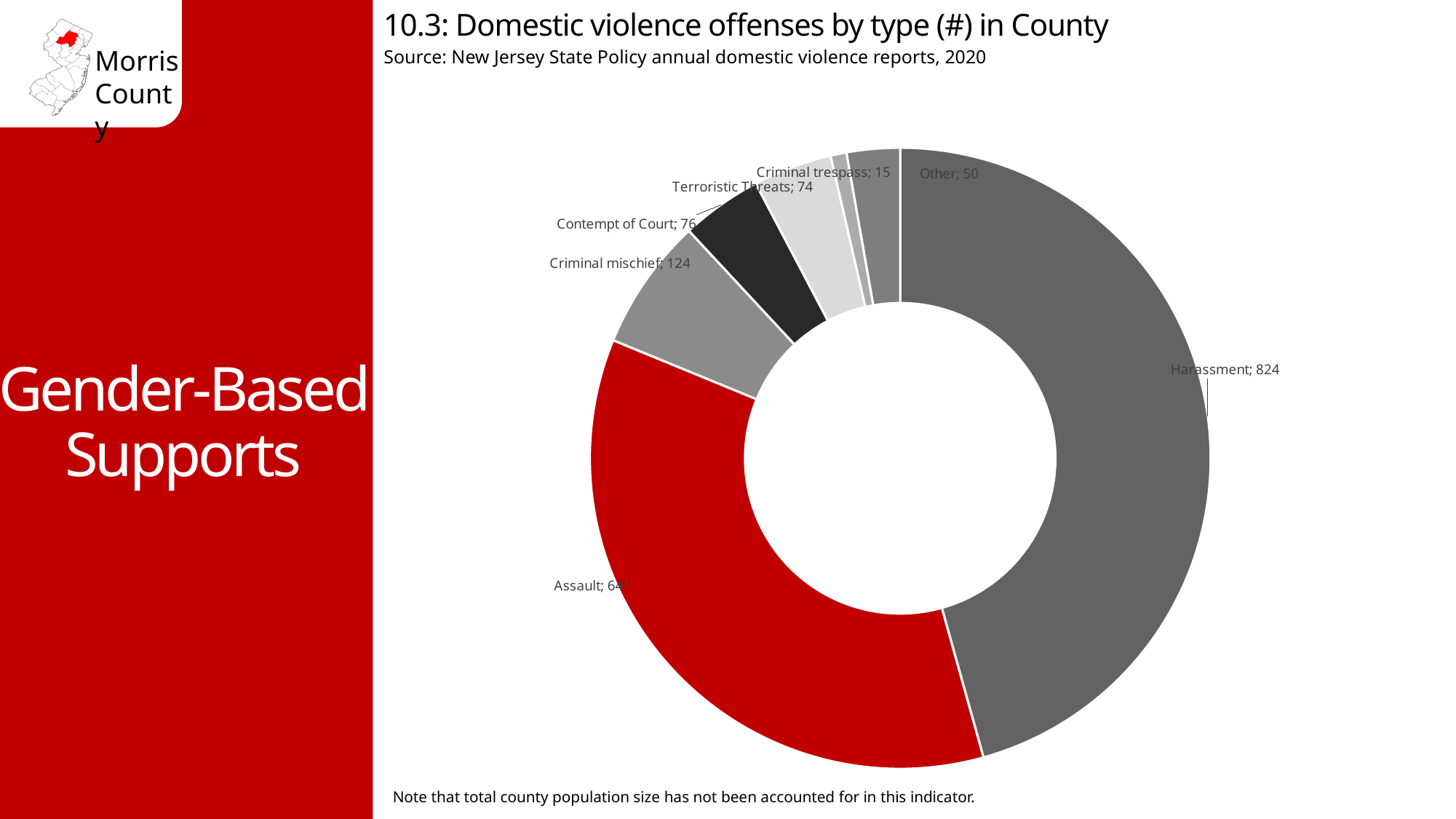
What is the number of Harassment offenses shown on the chart? 824 Which is larger, Criminal mischief or Other? Criminal mischief What value is shown for the Other category? 50 What value is shown for Criminal trespass? 15 What is the number of Assault offenses shown on the chart? 641 What is the title of the chart? 10.3: Domestic violence offenses by type (#) in County What is the difference between the Harassment and Assault values? 183 What kind of chart is shown on the slide? doughnut chart Which labeled offense type has the lowest number of offenses? Criminal trespass What value is shown for Criminal mischief? 124 Which offense type has the highest number of offenses? Harassment What is the difference between Criminal mischief and Contempt of Court? 48